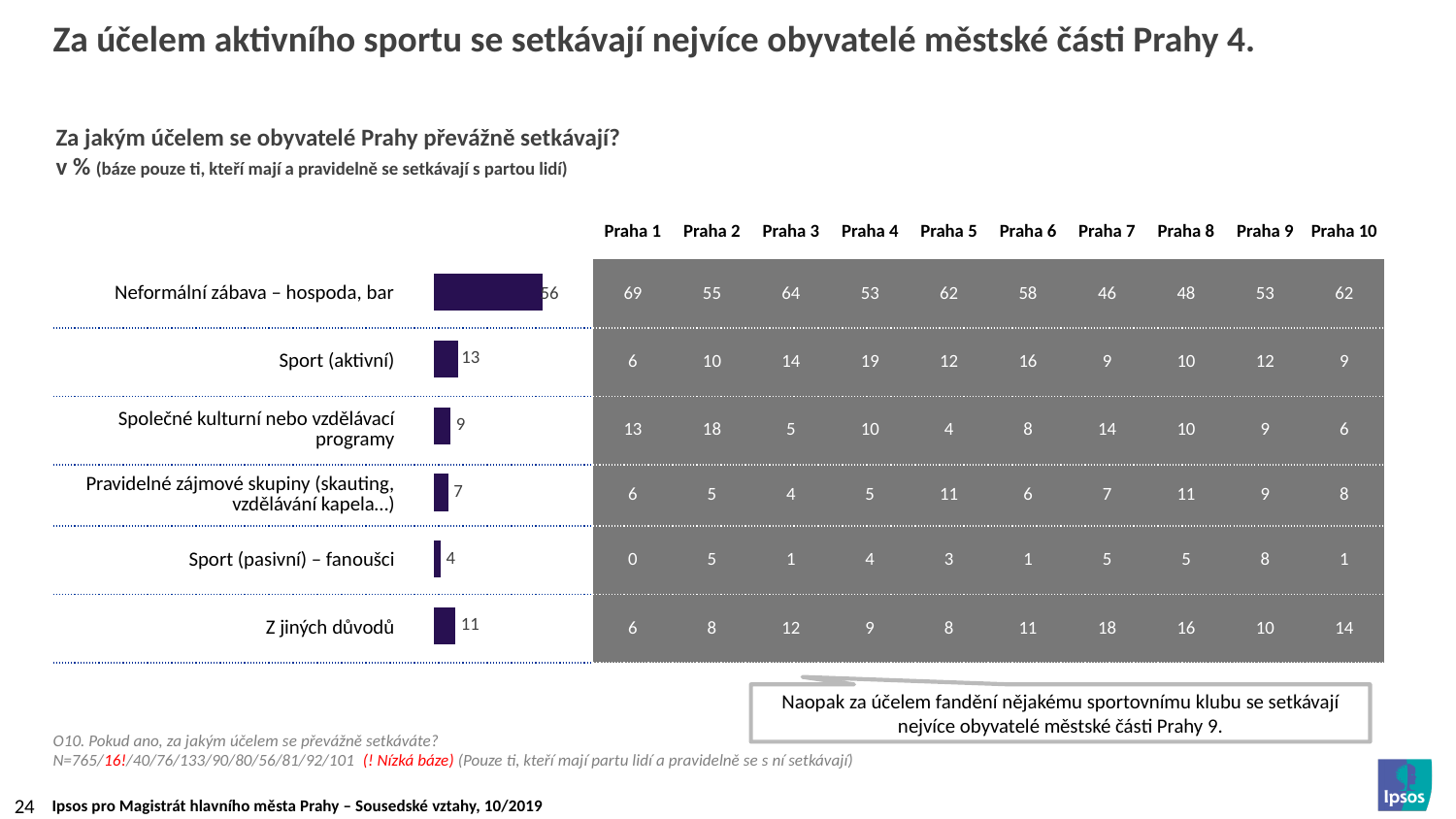
What is the value for "Z jiných důvodů" in the bar chart? 11 What is the value for "Neformální zábava – hospoda, bar" in the bar chart? 56 In the table next to the bar chart, which Praha district has the highest value for "Sport (pasivní) – fanoušci"? Praha 9 Which is larger in the bar chart: "Společné kulturní nebo vzdělávací programy" or "Pravidelné zájmové skupiny (skauting, vzdělávání kapela…)"? Společné kulturní nebo vzdělávací programy How many categories does the bar chart show? 6 In the table next to the bar chart, what is the value for "Sport (aktivní)" in Praha 4? 19 Which category has the lowest value in the bar chart? Sport (pasivní) – fanoušci What is the difference between the values for "Neformální zábava – hospoda, bar" and "Sport (aktivní)" in the bar chart? 43 What is the value for "Sport (aktivní)" in the bar chart? 13 Which category has the highest value in the bar chart? Neformální zábava – hospoda, bar What type of chart is shown on the slide? bar chart What is the difference between the values for "Z jiných důvodů" and "Sport (pasivní) – fanoušci" in the bar chart? 7